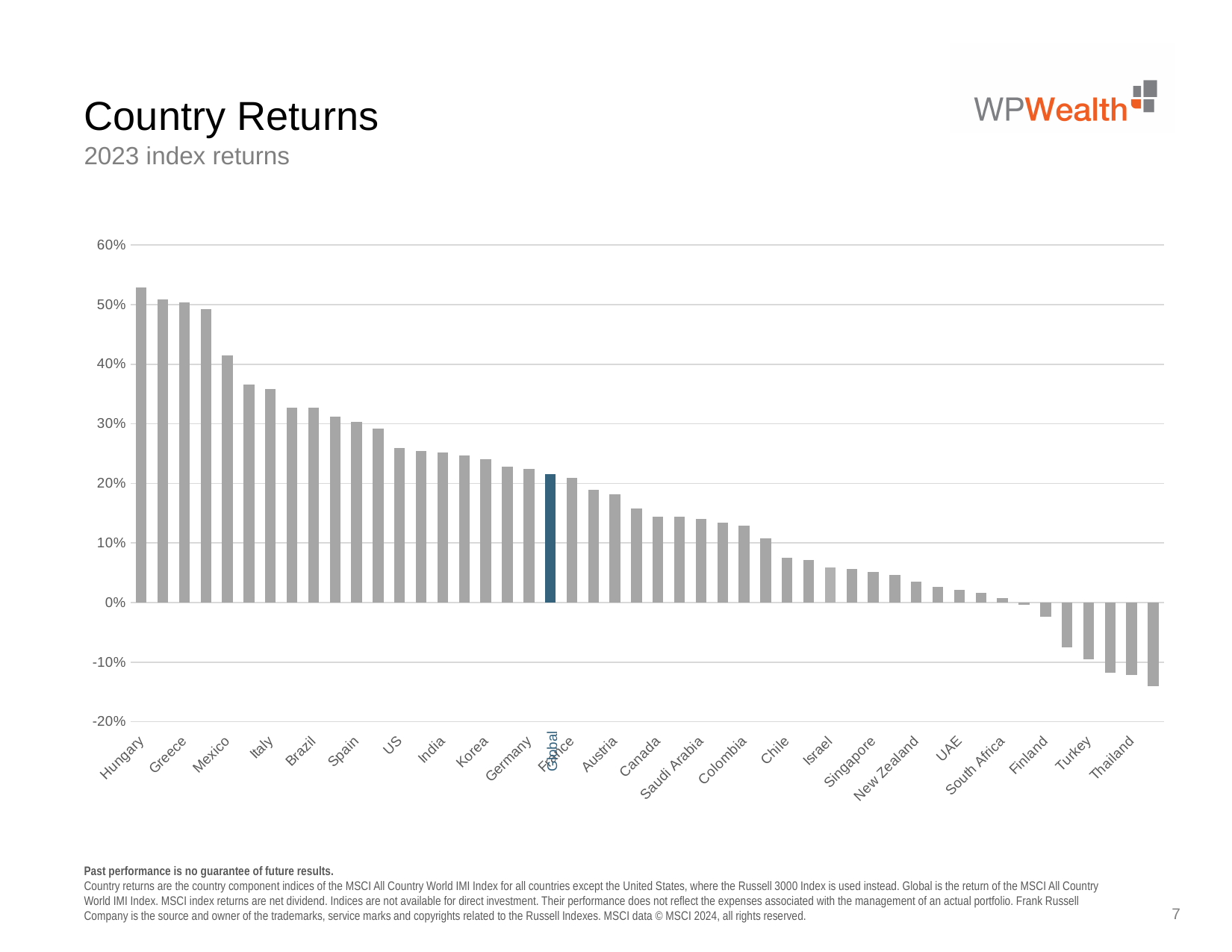
Is the value for Finland greater or less than 0%? less What kind of chart is shown on the slide? bar chart Which bar is highlighted in a different colour from the others? Global Is the value for Austria greater or less than 20%? less Do the values rise or fall moving from left to right along the x axis? fall Which has the larger return, Italy or Spain? Italy Is the value for Israel greater or less than 10%? less Which has the larger return, the US or Canada? US Which country has the highest 2023 index return? Hungary